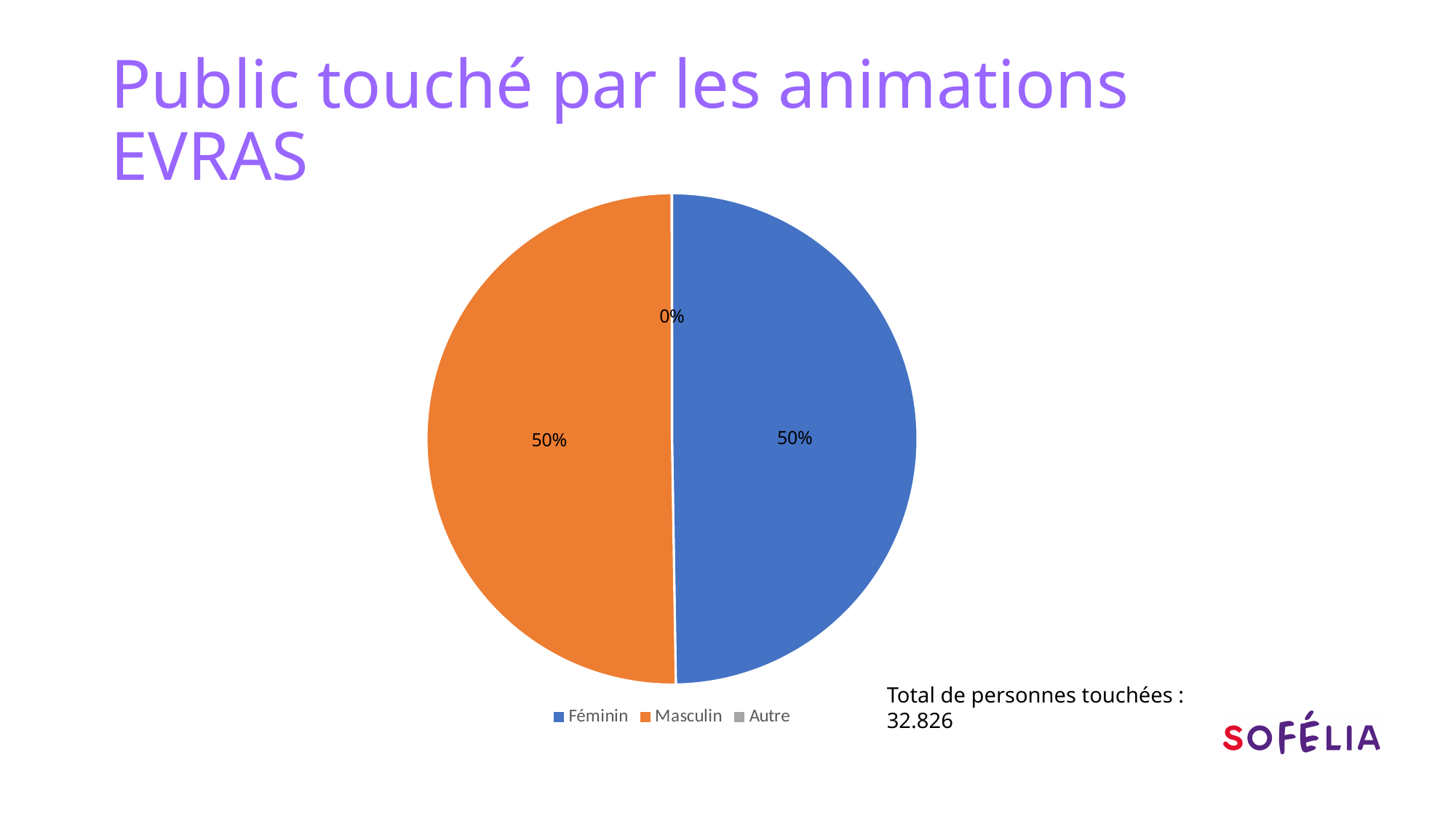
What is the difference between the Féminin and Masculin percentages? 0% Is the Féminin share greater or less than 25%? greater What percentage is shown for the Autre category? 0% How many categories does the legend of the pie chart list? 3 What total number of people reached is stated next to the chart? 32.826 What kind of chart is shown on the slide? Pie chart What share of the pie does the Masculin slice represent? 50% Which category has the smallest share of the pie chart? Autre What percentage of the pie chart is labelled for the Féminin slice? 50% What colour is used for the Masculin slice in the pie chart? Orange What percentage is shown for the Masculin slice? 50%